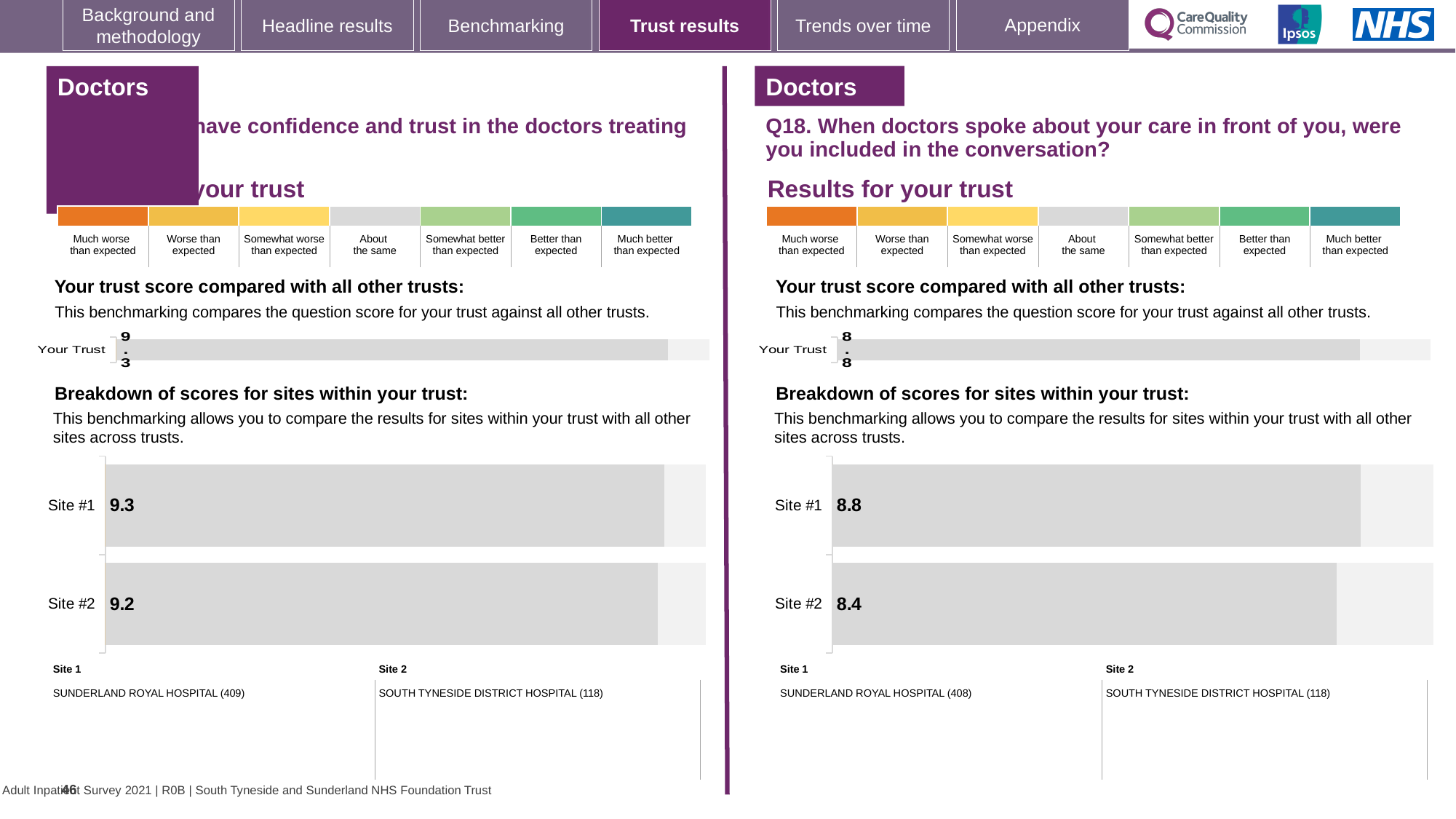
On the Q18 site breakdown chart, what is the difference between the Site #1 and Site #2 scores? 0.4 On the left-hand site breakdown chart, what is the score for Site #1? 9.3 Is the Site #2 score on the Q18 site breakdown chart greater or less than the Site #2 score on the left-hand site breakdown chart? less How many sites are shown on the Q18 site breakdown chart? 2 On the Q18 site breakdown chart, which site has the higher score? Site #1 On the Q18 'Your trust score compared with all other trusts' chart, what is the score for Your Trust? 8.8 On the left-hand site breakdown chart, what is the difference between the Site #1 and Site #2 scores? 0.1 On the Q18 site breakdown chart, what is the score for Site #1? 8.8 What type of chart is the Q18 site breakdown chart? Bar chart On the Q18 site breakdown chart, what is the score for Site #2? 8.4 On the left-hand site breakdown chart, what is the score for Site #2? 9.2 On the left-hand 'Your trust score compared with all other trusts' chart, what is the score for Your Trust? 9.3